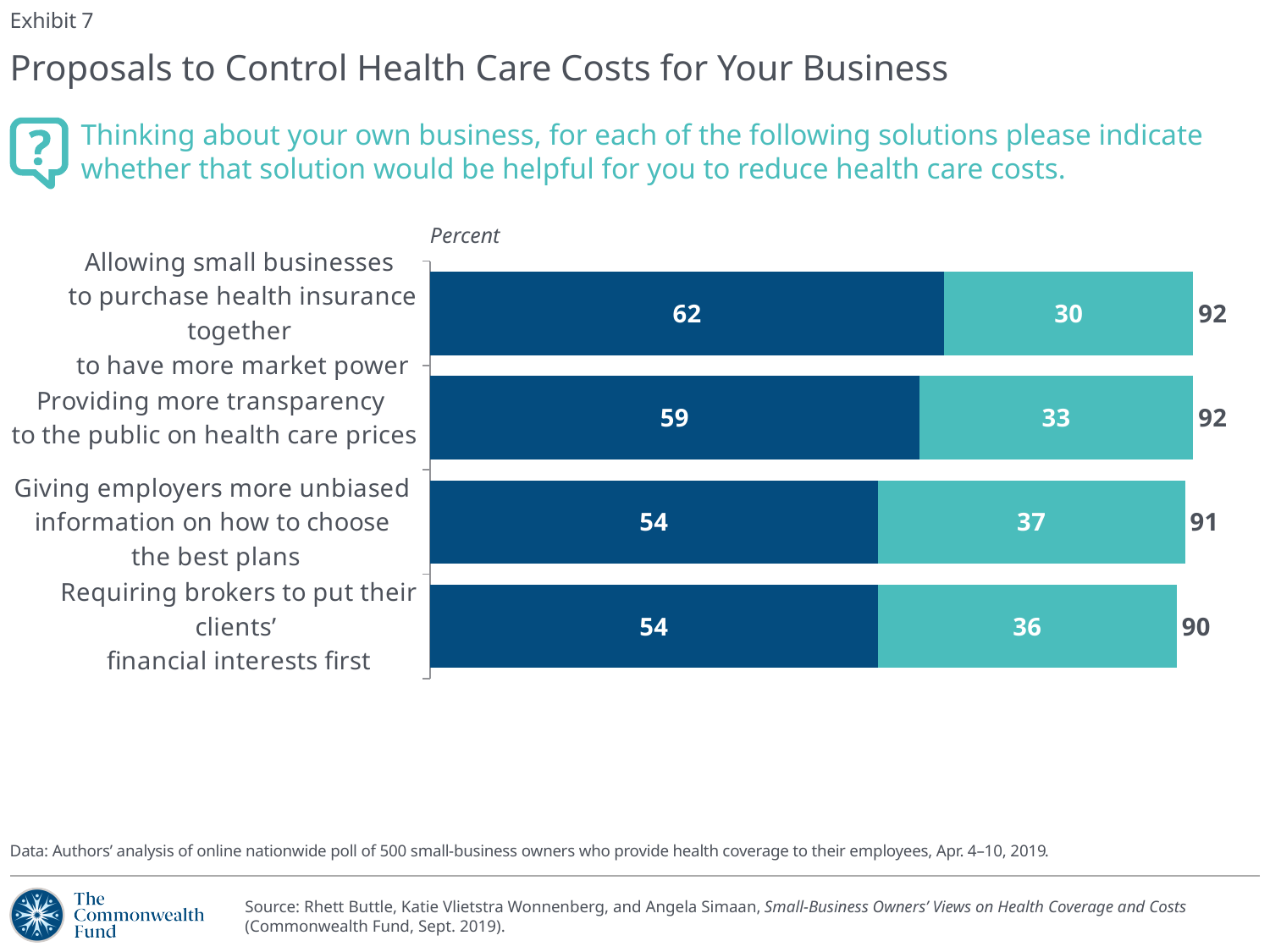
What kind of chart is shown on the slide? Stacked bar chart What is the total shown for 'Giving employers more unbiased information on how to choose the best plans'? 91 What is the difference between the dark blue values for 'Allowing small businesses to purchase health insurance together' and 'Providing more transparency to the public on health care prices'? 3 How many proposals (categories) are plotted in the chart? 4 Which is larger: the teal value for 'Providing more transparency to the public on health care prices' or the teal value for 'Requiring brokers to put their clients' financial interests first'? Requiring brokers to put their clients' financial interests first What is the dark blue segment value for 'Providing more transparency to the public on health care prices'? 59 What is the teal segment value for 'Giving employers more unbiased information on how to choose the best plans'? 37 What is the total shown for 'Requiring brokers to put their clients' financial interests first'? 90 What unit label is shown above the chart? Percent Which proposal has the lowest teal segment value? Allowing small businesses to purchase health insurance together to have more market power What is the dark blue segment value for 'Requiring brokers to put their clients' financial interests first'? 54 Which proposal has the highest dark blue segment value? Allowing small businesses to purchase health insurance together to have more market power